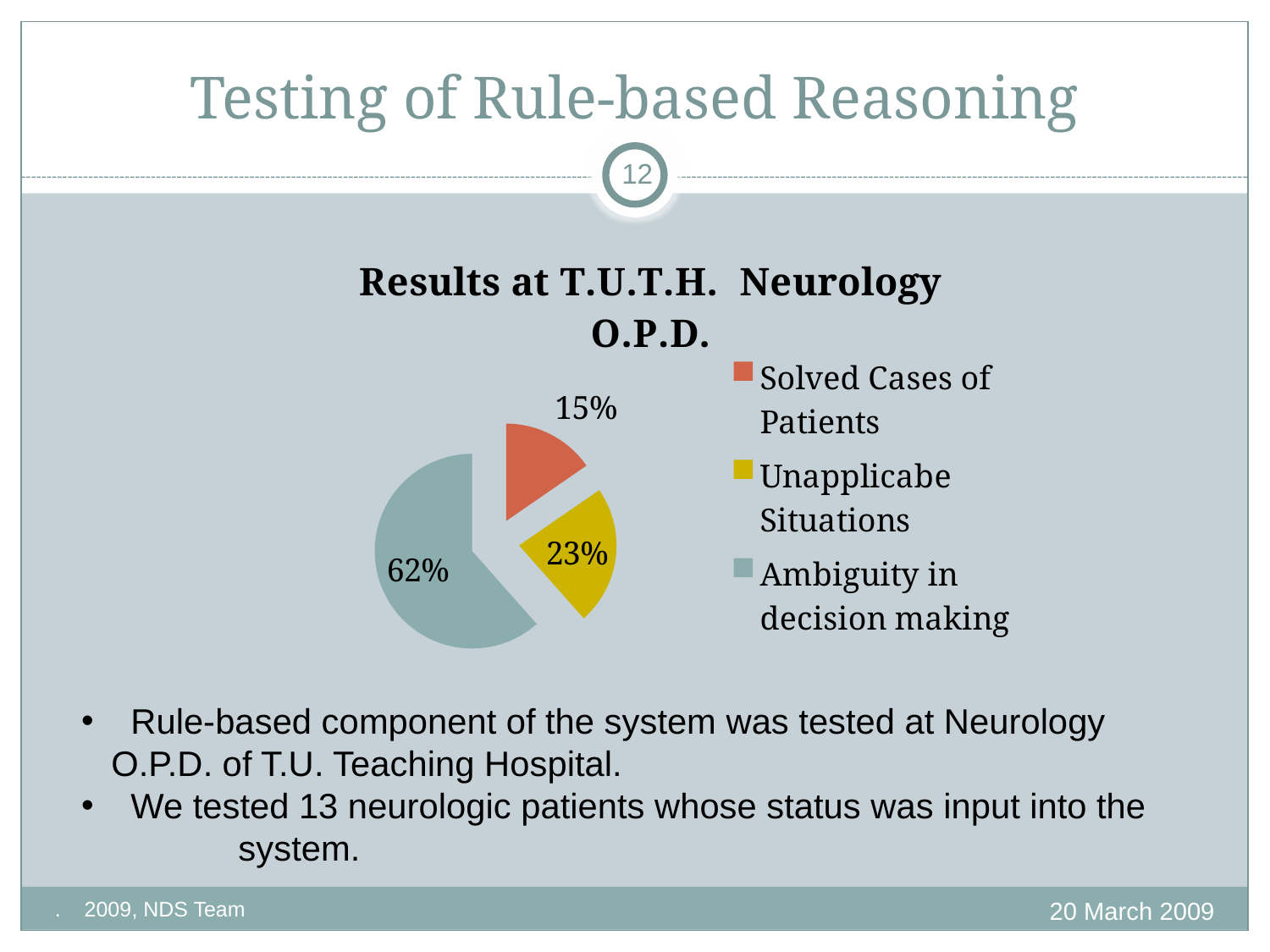
Which category has the smallest share of the pie? Solved Cases of Patients How many slices does the pie chart have? 3 What percentage of the pie is Solved Cases of Patients? 15% What percentage of the pie is Unapplicabe Situations? 23% Which category has the largest share of the pie? Ambiguity in decision making What is the difference in percentage points between Ambiguity in decision making and Unapplicabe Situations? 39 What type of chart is shown on the slide? Pie chart What is the difference in percentage points between Unapplicabe Situations and Solved Cases of Patients? 8 What is the title of the chart? Results at T.U.T.H. Neurology O.P.D. Which is larger: the share for Unapplicabe Situations or the share for Solved Cases of Patients? Unapplicabe Situations Which colour represents Unapplicabe Situations in the legend? Yellow What percentage of the pie is Ambiguity in decision making? 62%